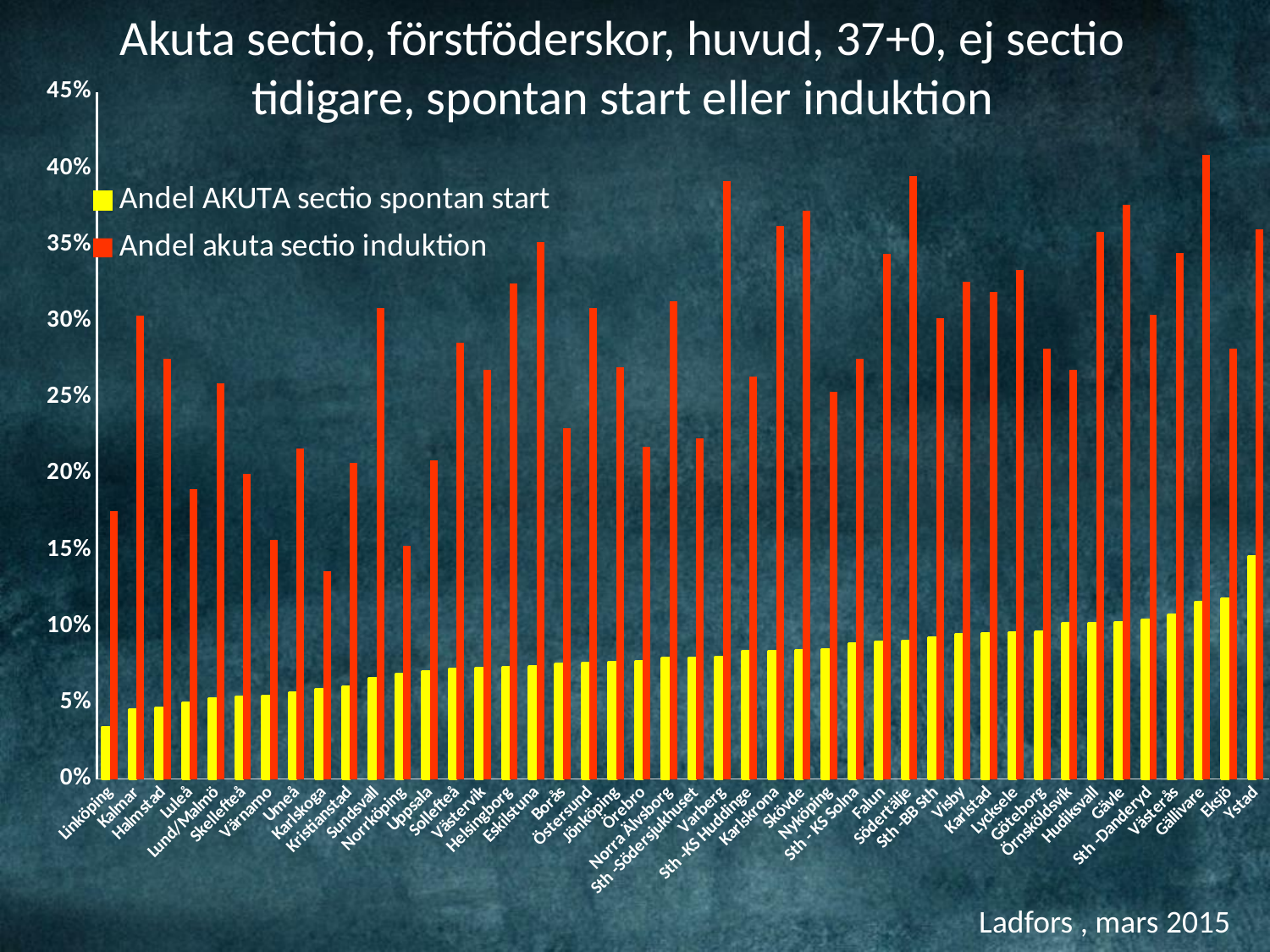
Is the value for Andel akuta sectio induktion at Varberg greater or less than 35%? greater Is the value for Andel akuta sectio induktion at Karlskoga greater or less than 15%? less Which hospital has the lowest value for Andel AKUTA sectio spontan start? Linköping Is the value for Andel akuta sectio induktion at Linköping greater or less than 15%? greater What kind of chart is shown on the slide? bar chart How many hospitals (categories) are shown on the x axis? 44 How many series does the legend list? 2 Which is larger at Linköping: Andel AKUTA sectio spontan start or Andel akuta sectio induktion? Andel akuta sectio induktion Which hospital has the highest value for Andel AKUTA sectio spontan start? Ystad Which colour represents Andel akuta sectio induktion in the legend? red Do the values for Andel AKUTA sectio spontan start rise or fall from left to right along the x axis? rise